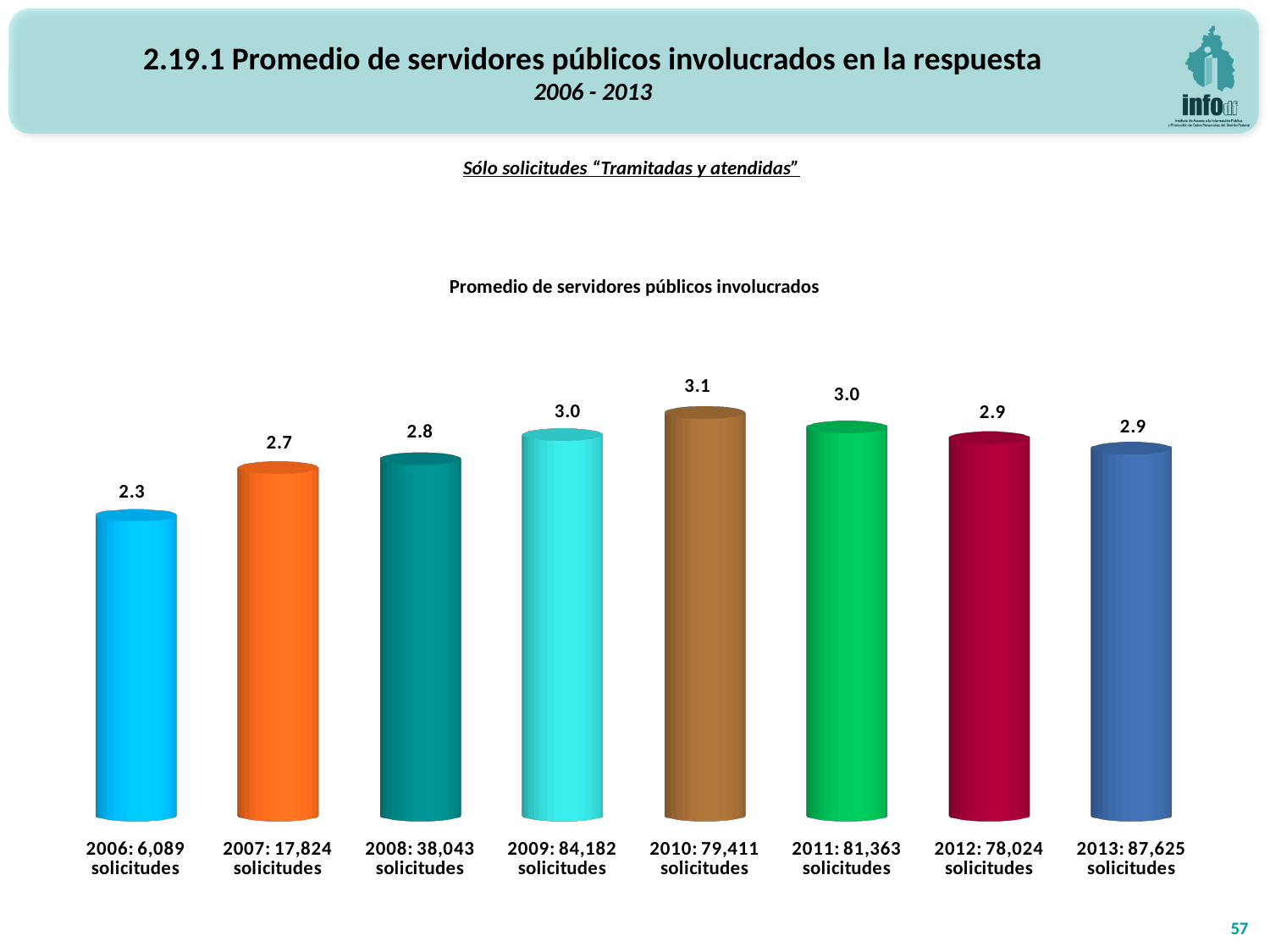
How many years (bars) are shown in the chart? 8 What is the title of the chart? Promedio de servidores públicos involucrados Which year has the lowest average number of public servants involved? 2006 What is the value shown for 2010? 3.1 How many solicitudes are indicated in the category label for 2013? 87,625 What is the value shown for 2013? 2.9 Which year has the highest average number of public servants involved? 2010 What is the average number of public servants involved for 2006? 2.3 Do the values rise or fall from 2006 to 2010? Rise What kind of chart is shown on the slide? Bar chart Which is larger, the value for 2008 or the value for 2012? 2012 What is the difference between the values for 2010 and 2006? 0.8